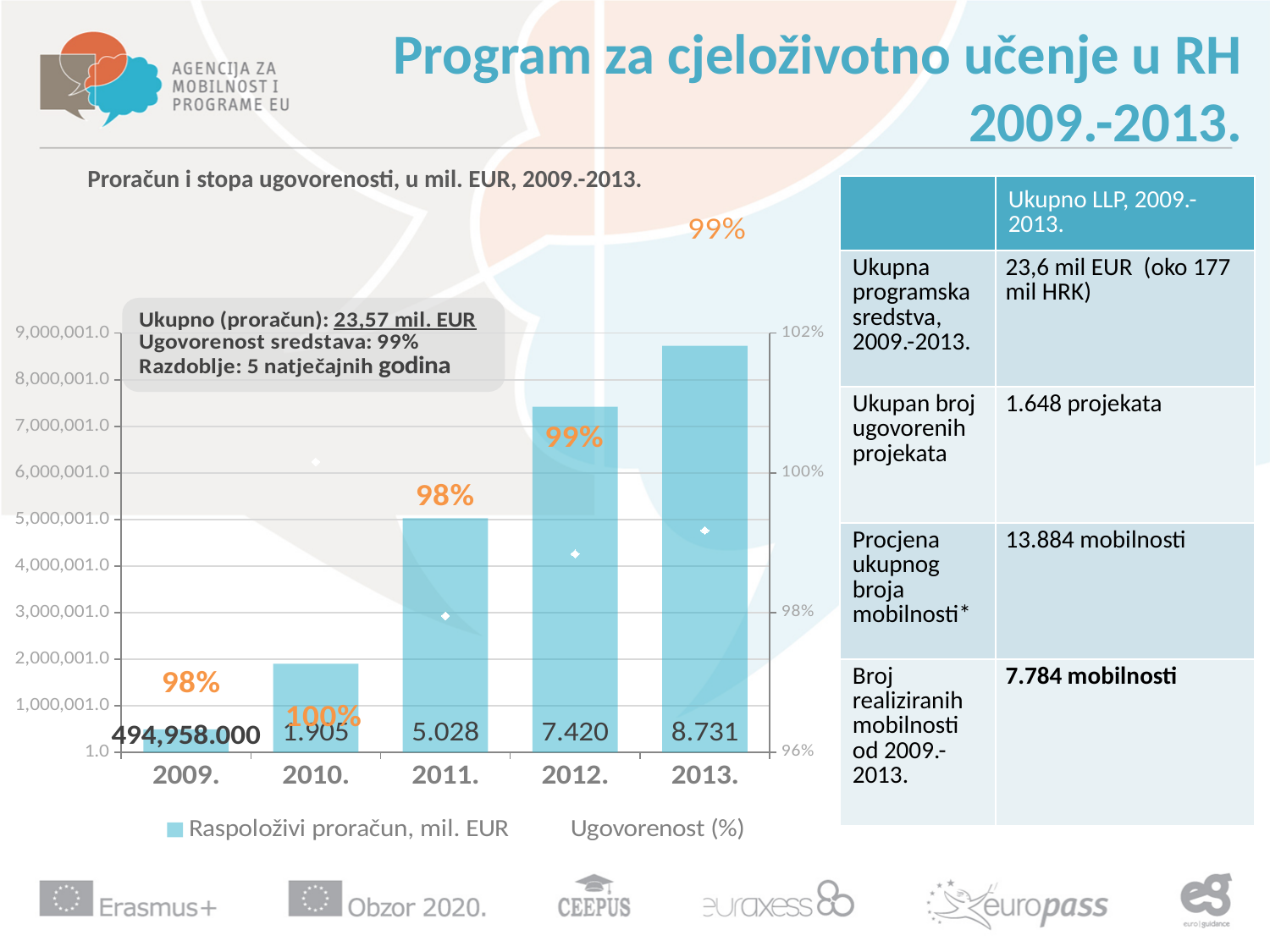
Do the Raspoloživi proračun bars rise or fall from 2009. to 2013.? rise What is the value of Raspoloživi proračun for 2013.? 8.731 What is the Ugovorenost (%) value shown for 2011.? 98% Which year has the larger Raspoloživi proračun bar, 2011. or 2012.? 2012. Which year has the highest Ugovorenost (%) value? 2010. Which year has the lowest Raspoloživi proračun bar? 2009. How many years are shown on the x axis of the chart? 5 Which year has the highest Raspoloživi proračun bar? 2013. What are the two series named in the chart legend? Raspoloživi proračun, mil. EUR and Ugovorenost (%) What is the difference between the Raspoloživi proračun values for 2013. and 2012.? 1.311 How many series does the chart legend list? 2 What is the Ugovorenost (%) value shown for 2010.? 100%